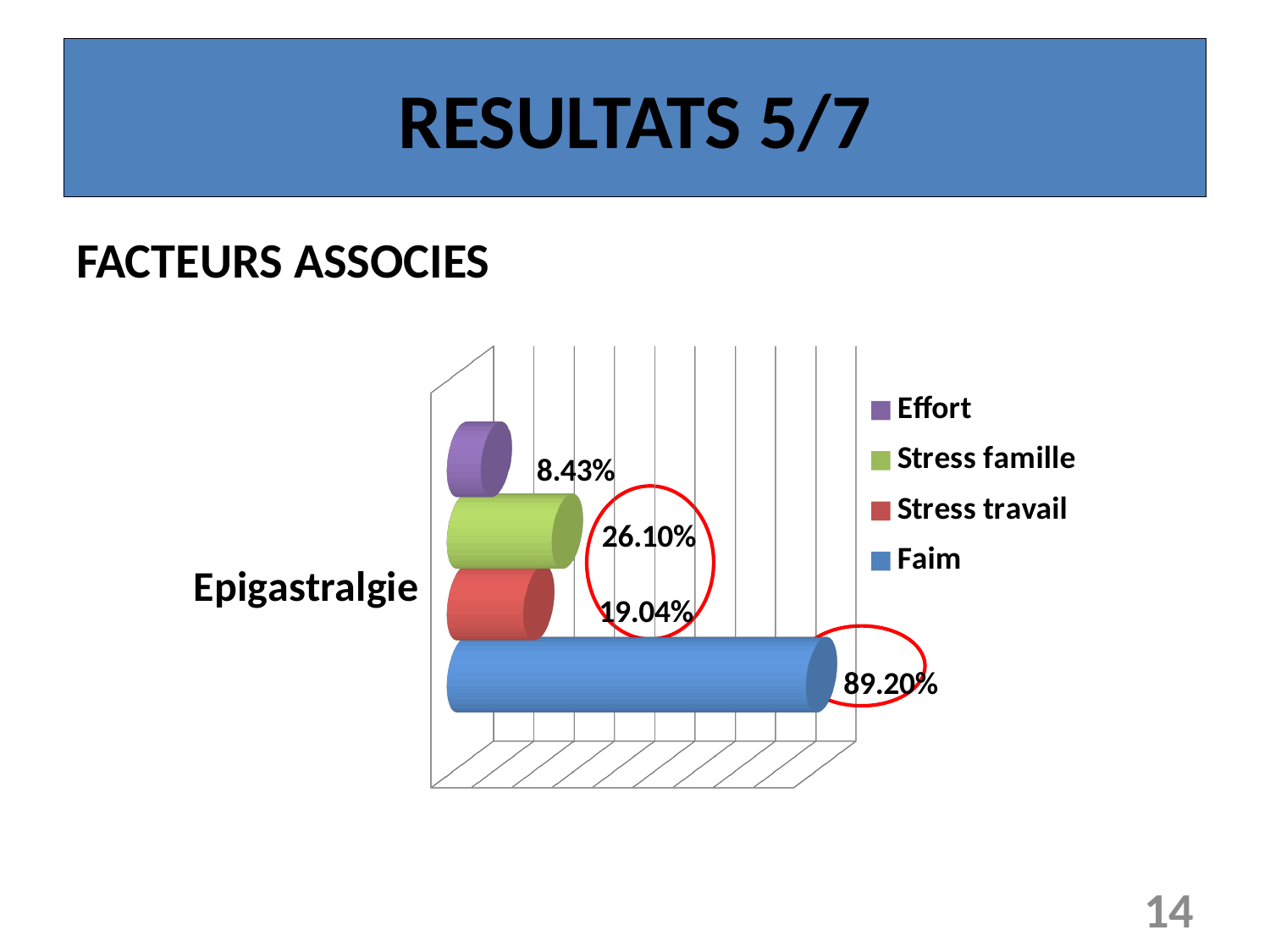
What is the difference between the values for Faim and Stress famille? 63.10% What is the value for Effort in the chart? 8.43% What is the category label shown on the chart's axis? Epigastralgie Which is larger, the value for Stress travail or the value for Effort? Stress travail What is the value for Stress famille in the chart? 26.10% What is the difference between the values for Stress famille and Stress travail? 7.06% What is the value for Faim in the chart? 89.20% How many series does the legend list? 4 Which series has the lowest value in the chart? Effort Which series has the highest value in the chart? Faim What is the value for Stress travail in the chart? 19.04% What kind of chart is shown on the slide? Bar chart